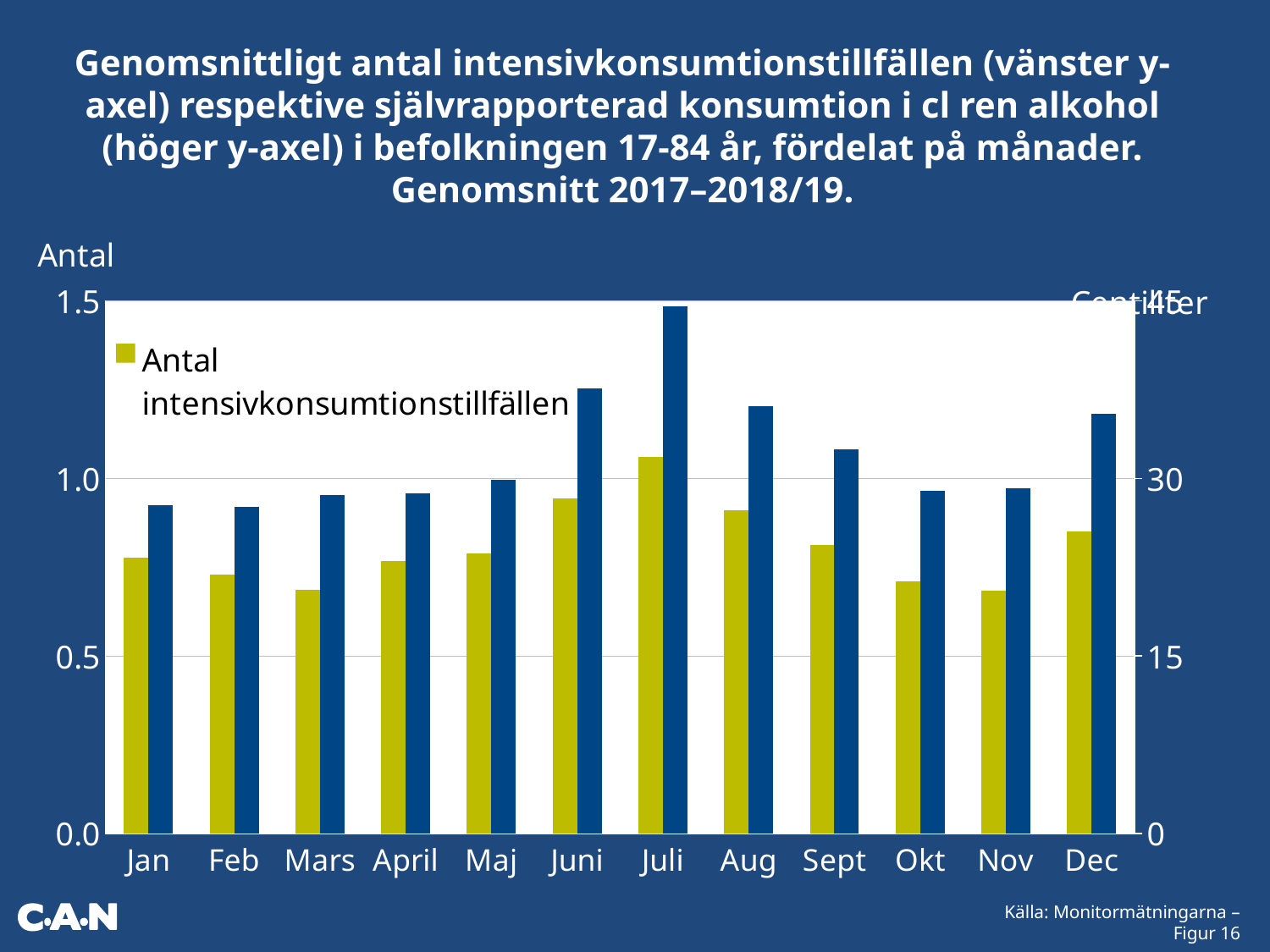
Which month has the highest value for the blue bars (consumption in centiliter, right y axis)? Juli How many months are shown on the x axis of the chart? 12 Which month has the larger value for Antal intensivkonsumtionstillfällen, Aug or Sept? Aug What source is cited at the bottom of the slide? Monitormätningarna – Figur 16 Is the blue bar (centiliter, right y axis) for Jan greater or less than 30? less Is the value for Antal intensivkonsumtionstillfällen in Juni greater or less than 1.0? less Which month has the larger blue bar (centiliter), Juni or Dec? Juni What kind of chart is shown on the slide? bar chart What is the label of the left y axis? Antal Which month has the highest value for Antal intensivkonsumtionstillfällen (yellow bars)? Juli Is the value for Antal intensivkonsumtionstillfällen in Juli greater or less than 1.0? greater